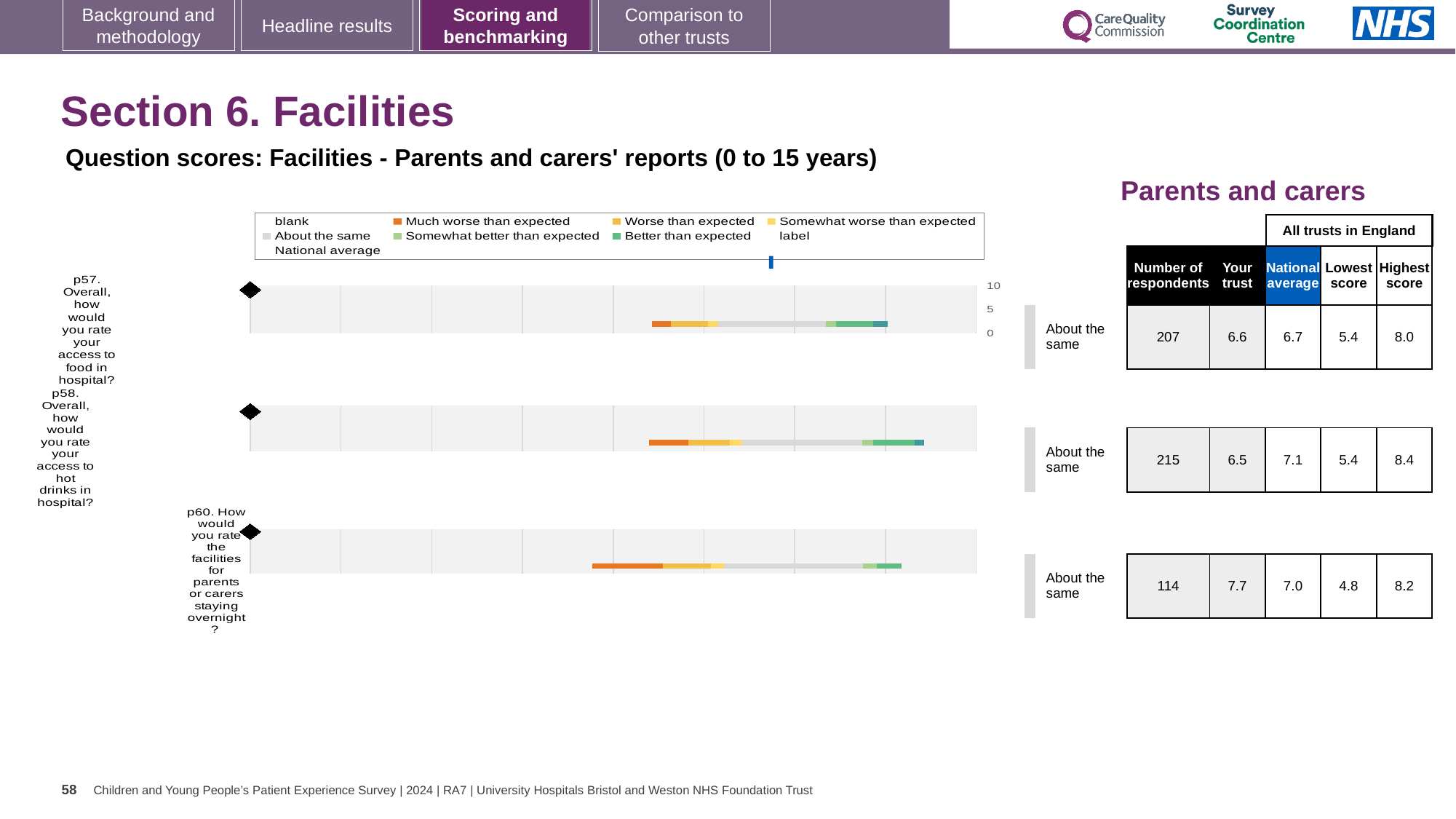
What is the national average score for p58 (access to hot drinks in hospital)? 7.1 Which question has the lowest 'Your trust' score? p58 What is the highest score among all trusts in England for p58? 8.4 What benchmark category is shown next to the bar for p57? About the same For p60, what is the difference between the 'Your trust' score and the national average? 0.7 For p57, which is larger: the 'Your trust' score or the national average? National average How many questions (bars) are plotted in the Facilities chart? 3 Which question has the highest 'Your trust' score? p60 What is the lowest score among all trusts in England for p60? 4.8 How many respondents answered p60 (facilities for parents or carers staying overnight)? 114 What kind of chart is used to show the question scores for Facilities? bar chart What is the 'Your trust' score for p57 (access to food in hospital)? 6.6